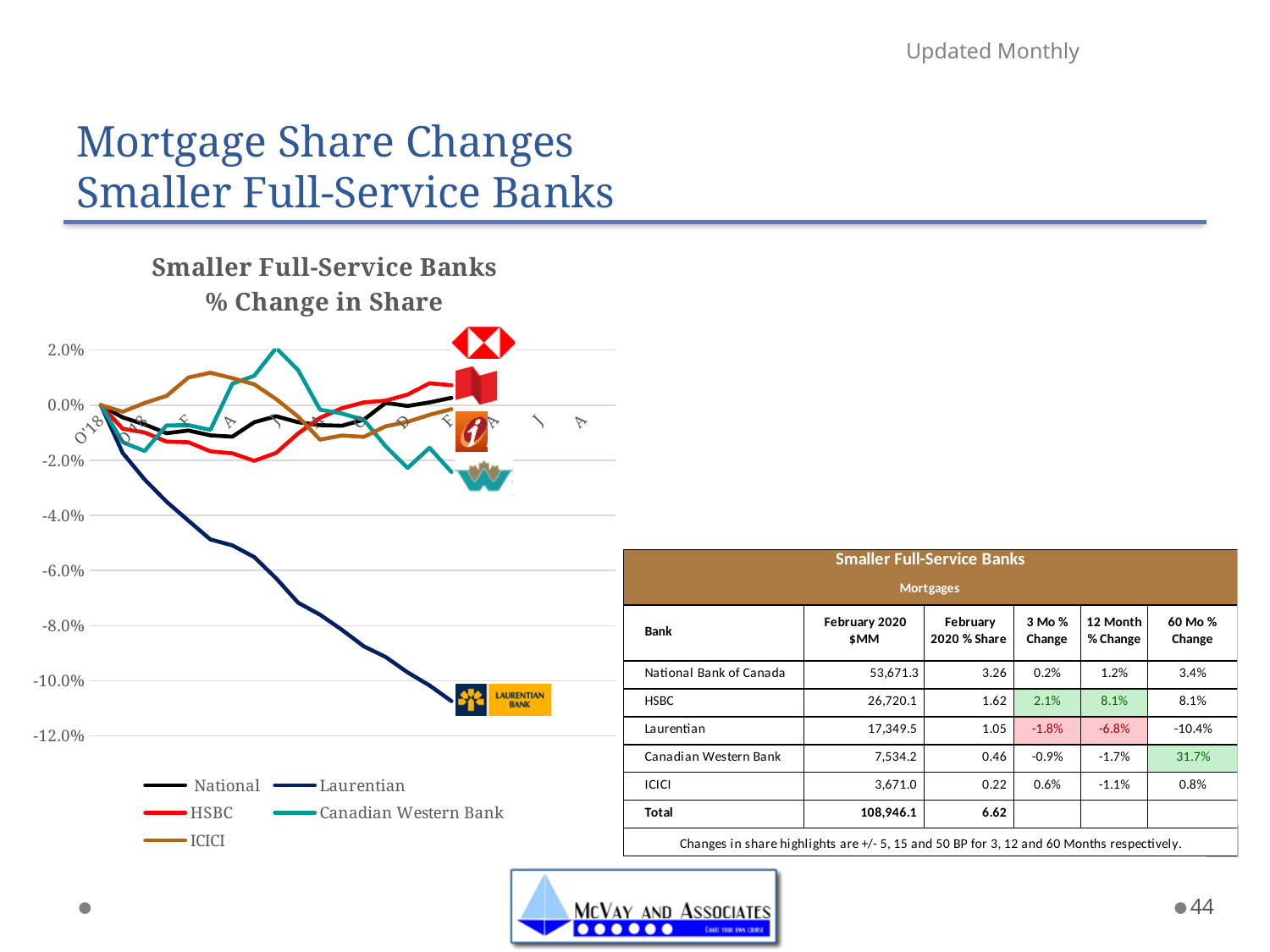
Is the final value for Laurentian greater or less than -8.0%? less Which series is drawn in red on the chart? HSBC Is the final value for Laurentian greater or less than -10.0%? less Which series reaches the highest value anywhere on the chart? Canadian Western Bank Is the peak value for Canadian Western Bank greater or less than 1.0%? greater How many series does the chart's legend list? 5 Which series ends at the lowest value at the end of the period shown? Laurentian At the end of the period, is the HSBC line higher or lower than the Laurentian line? higher What is the title of the chart? Smaller Full-Service Banks % Change in Share What kind of chart is shown on the slide? line chart Does the Laurentian line rise or fall across the period shown? fall